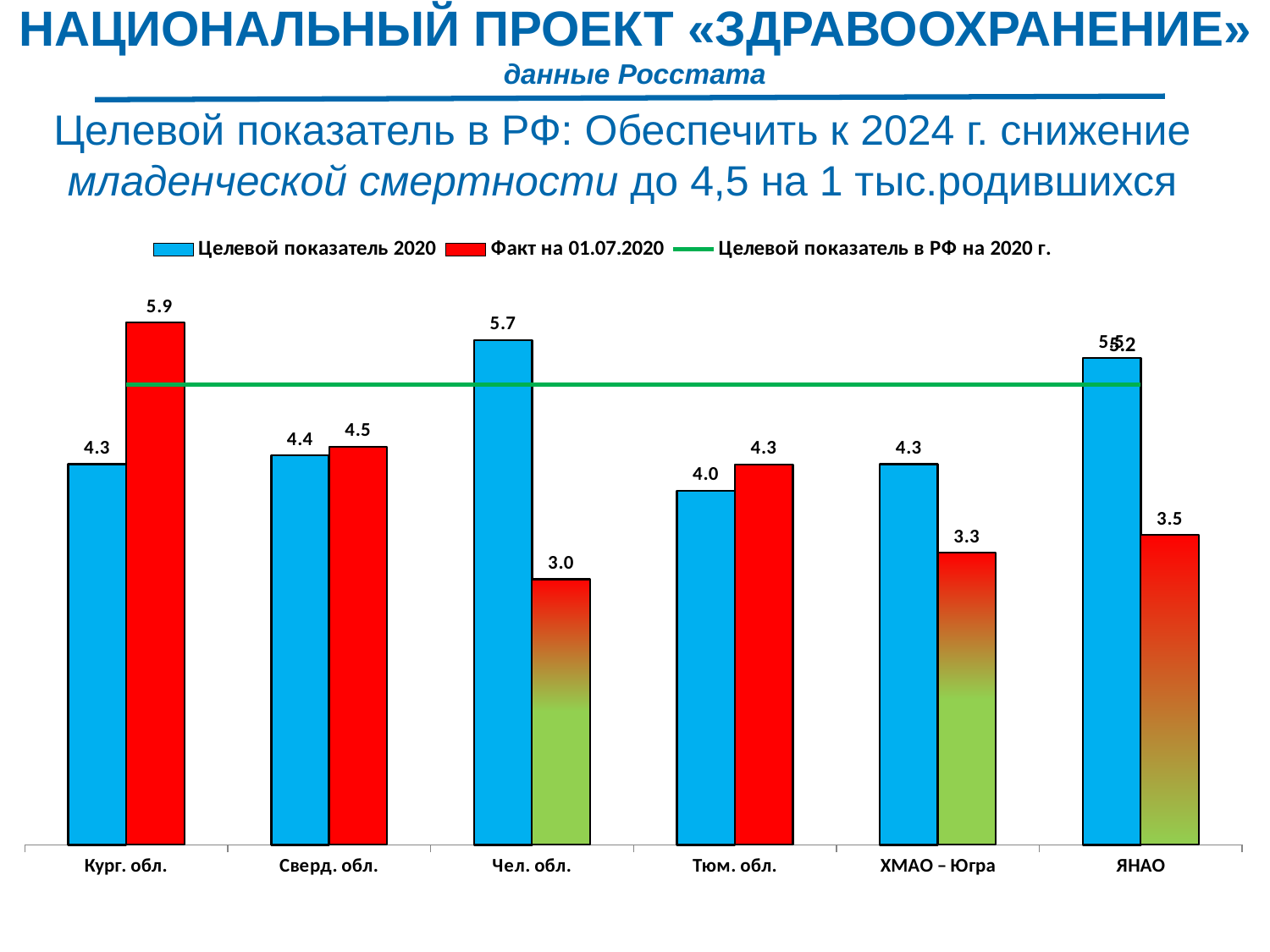
How many regions are shown on the x axis of the chart? 6 What is the value of «Целевой показатель 2020» for Тюм. обл.? 4.0 What is the value of «Целевой показатель 2020» for Чел. обл.? 5.7 What is the value of «Факт на 01.07.2020» for ХМАО – Югра? 3.3 What kind of chart is shown on the slide? Combination bar and line chart What is the value of «Факт на 01.07.2020» for Чел. обл.? 3.0 Which region has the highest value of «Факт на 01.07.2020»? Кург. обл. What is the value of «Факт на 01.07.2020» for Кург. обл.? 5.9 How many entries does the chart legend list? 3 For Кург. обл., how much higher is «Факт на 01.07.2020» than «Целевой показатель 2020»? 1.6 For ХМАО – Югра, which is larger: «Целевой показатель 2020» or «Факт на 01.07.2020»? Целевой показатель 2020 Which region has the lowest value of «Факт на 01.07.2020»? Чел. обл.